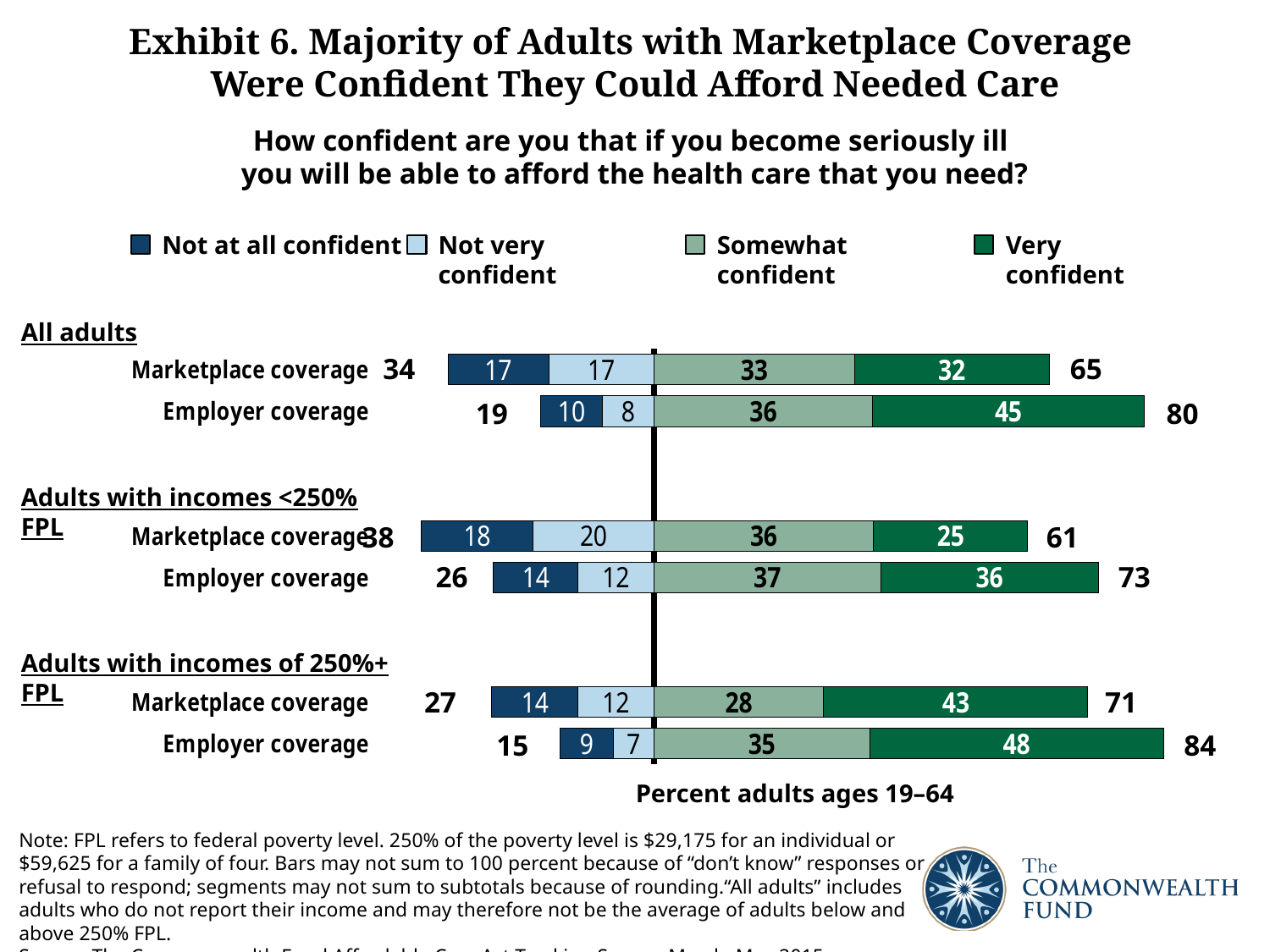
What is the combined 'Somewhat confident' and 'Very confident' subtotal for Employer coverage among adults with incomes of 250%+ FPL? 84 How many response categories does the legend list? 4 What is the 'Very confident' value for Employer coverage among all adults? 45 What kind of chart is shown on the slide? bar chart What is the difference between the 'Very confident' values for Employer coverage and Marketplace coverage among all adults? 13 Which bar has the highest 'Very confident' value? Employer coverage, adults with incomes of 250%+ FPL What is the label on the horizontal axis of the chart? Percent adults ages 19–64 Among adults with incomes <250% FPL, which has the larger 'Not very confident' value, Marketplace coverage or Employer coverage? Marketplace coverage What is the 'Not at all confident' value for Marketplace coverage among adults with incomes of 250%+ FPL? 14 How many bars are plotted on the chart? 6 Which bar has the lowest combined 'Not at all confident' and 'Not very confident' subtotal? Employer coverage, adults with incomes of 250%+ FPL What is the 'Somewhat confident' value for Marketplace coverage among adults with incomes <250% FPL? 36